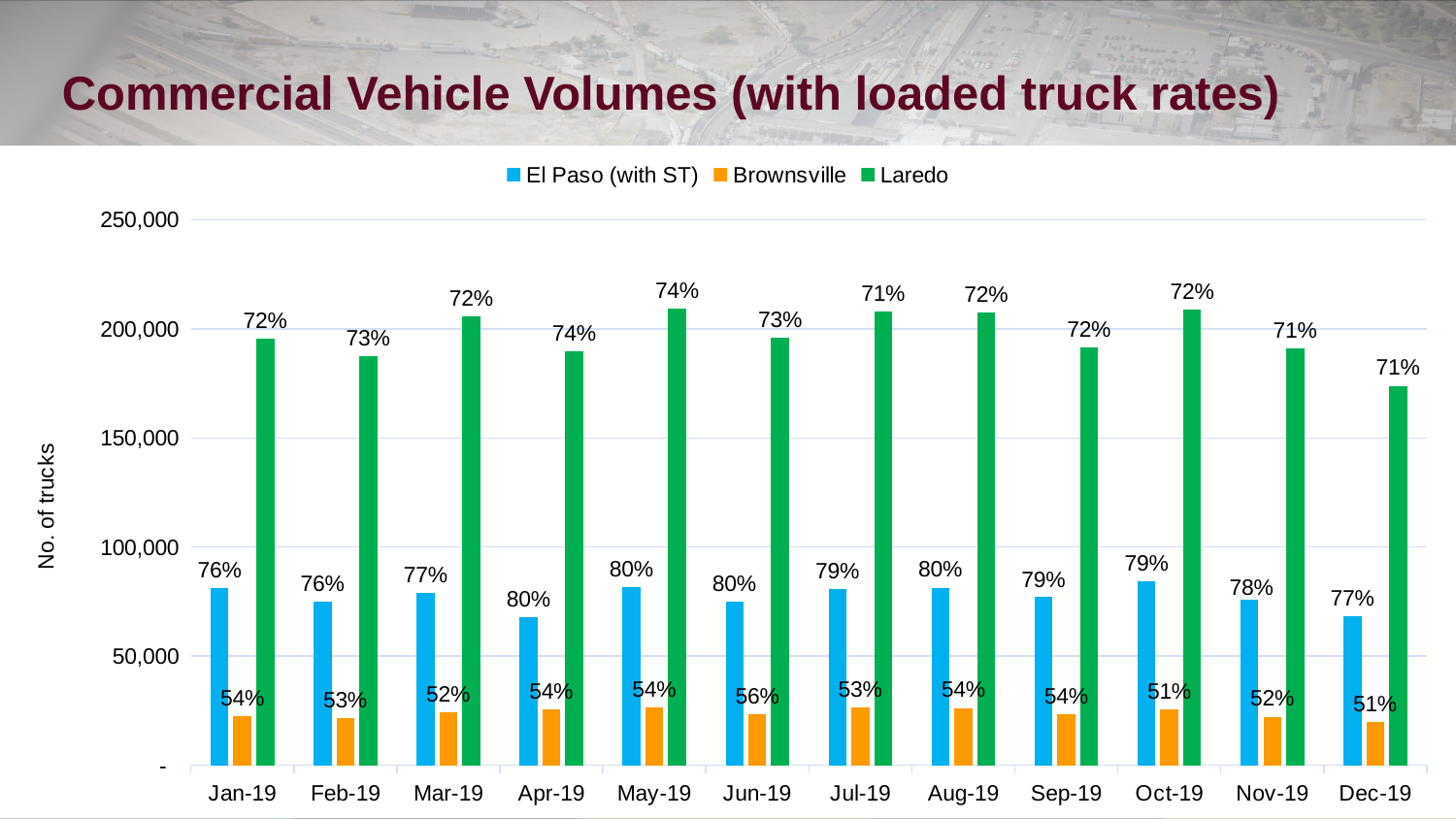
In which month is the Brownsville loaded truck rate label highest? Jun-19 What loaded truck rate is labelled for Brownsville in Jun-19? 56% What kind of chart is shown on the slide? Bar chart Is the number of trucks for Laredo in Dec-19 greater or less than 200,000? less How many months are shown along the x axis? 12 Is the number of trucks for El Paso (with ST) in Oct-19 greater or less than 100,000? less What loaded truck rate is labelled for Laredo in May-19? 74% In Jan-19, which has the taller bar, El Paso (with ST) or Laredo? Laredo How many series does the legend list? 3 What loaded truck rate is labelled for El Paso (with ST) in Apr-19? 80% What is the difference between the El Paso (with ST) and Brownsville loaded truck rate labels in Jan-19? 22 percentage points What is the label on the vertical axis? No. of trucks